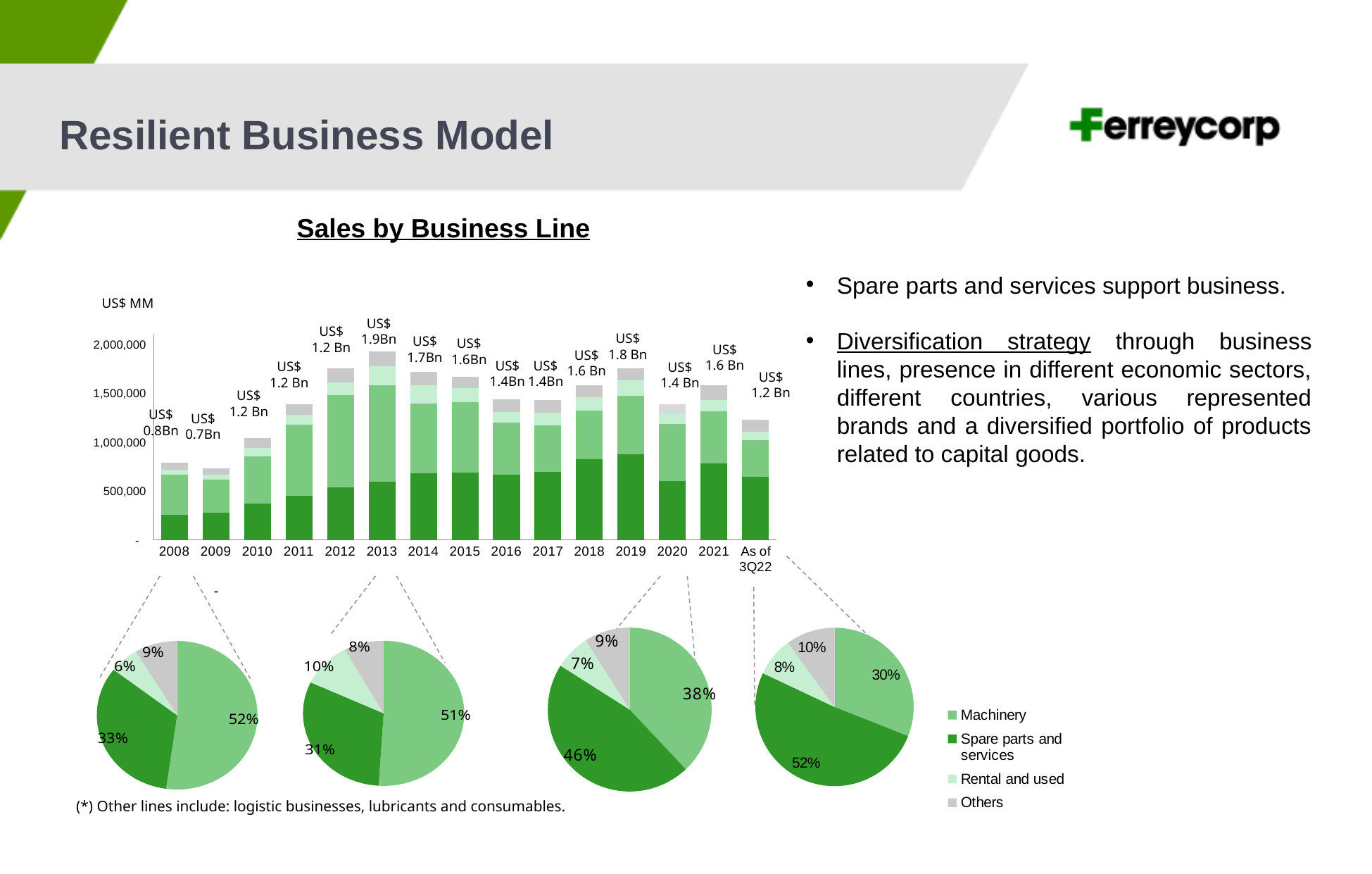
In the 'Sales by Business Line' bar chart, which year has the lowest total sales? 2009 In the 'Sales by Business Line' bar chart, what total sales value is labelled above the 2013 bar? US$ 1.9Bn In the 'Sales by Business Line' bar chart, which year has the highest total sales? 2013 In the 'Sales by Business Line' bar chart, how many bars (periods) are shown along the x axis? 15 In the 'Sales by Business Line' bar chart, which year has higher total sales, 2019 or 2020? 2019 In the third pie chart from the left, what share does Others have? 9% What kind of chart is the 'Sales by Business Line' chart at the top of the slide? Stacked bar chart How many series does the legend on the slide list? 4 In the leftmost pie chart, what share does Machinery have? 52% In the 'Sales by Business Line' bar chart, is the total for 2008 greater or less than 1,000,000? less In the rightmost pie chart, what share does Spare parts and services have? 52% What are the four legend entries shown on the slide? Machinery, Spare parts and services, Rental and used, Others